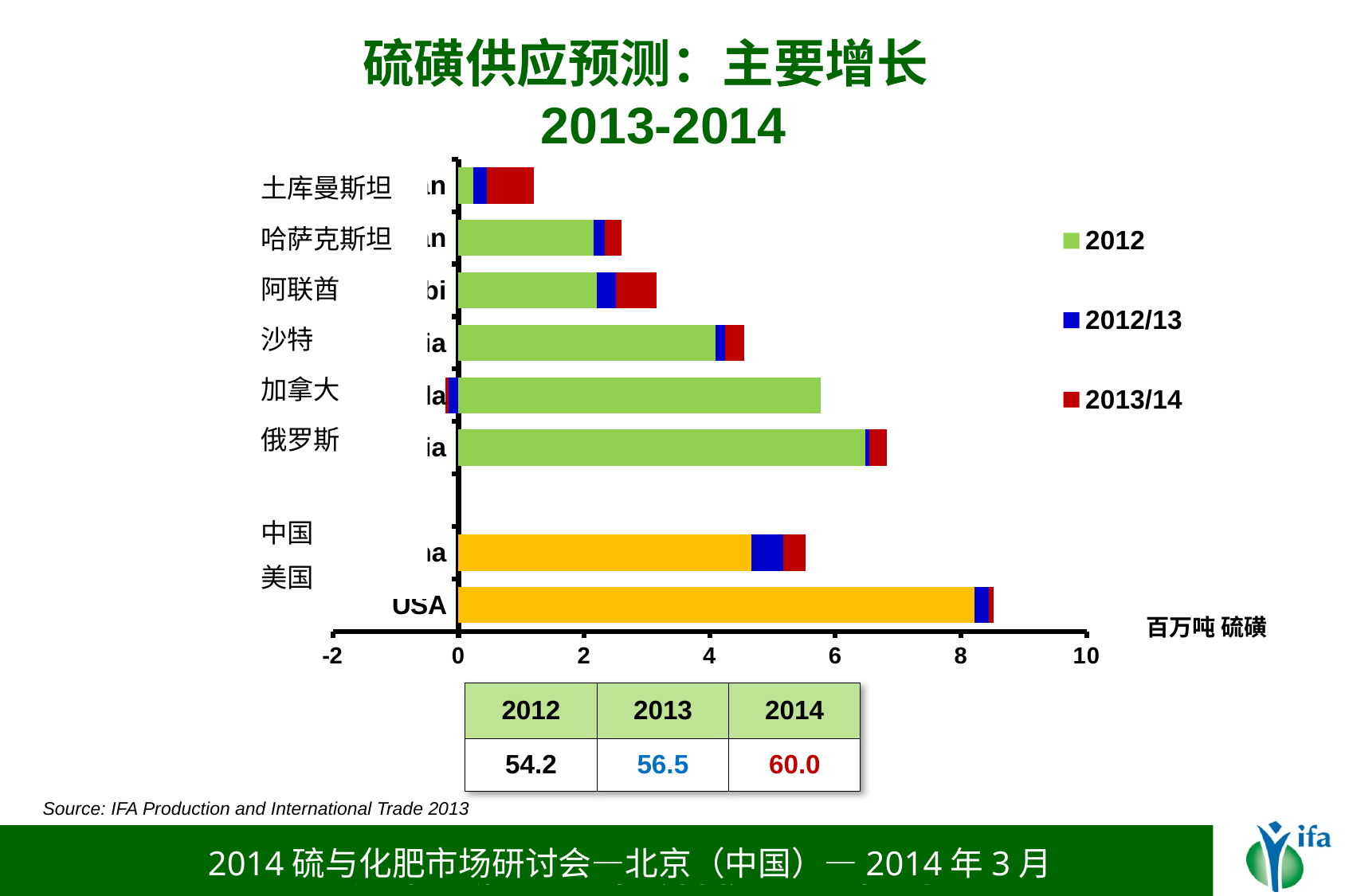
What kind of chart is shown on the slide? bar chart Is the 2012 value for 土库曼斯坦 greater or less than 2? less What unit label is shown next to the x axis of the chart? 百万吨 硫磺 Which country has the shortest total bar in the chart? 土库曼斯坦 Is the 2012 value for 加拿大 greater or less than 6? less How many series does the chart legend list? 3 Which country has the longest total bar in the chart? 美国 (USA) Is the 2012 value for 美国 (USA) greater or less than 8? greater Which has the larger 2012 value, 俄罗斯 or 加拿大? 俄罗斯 How many countries are plotted in the chart? 8 What are the three series listed in the chart legend? 2012, 2012/13, 2013/14